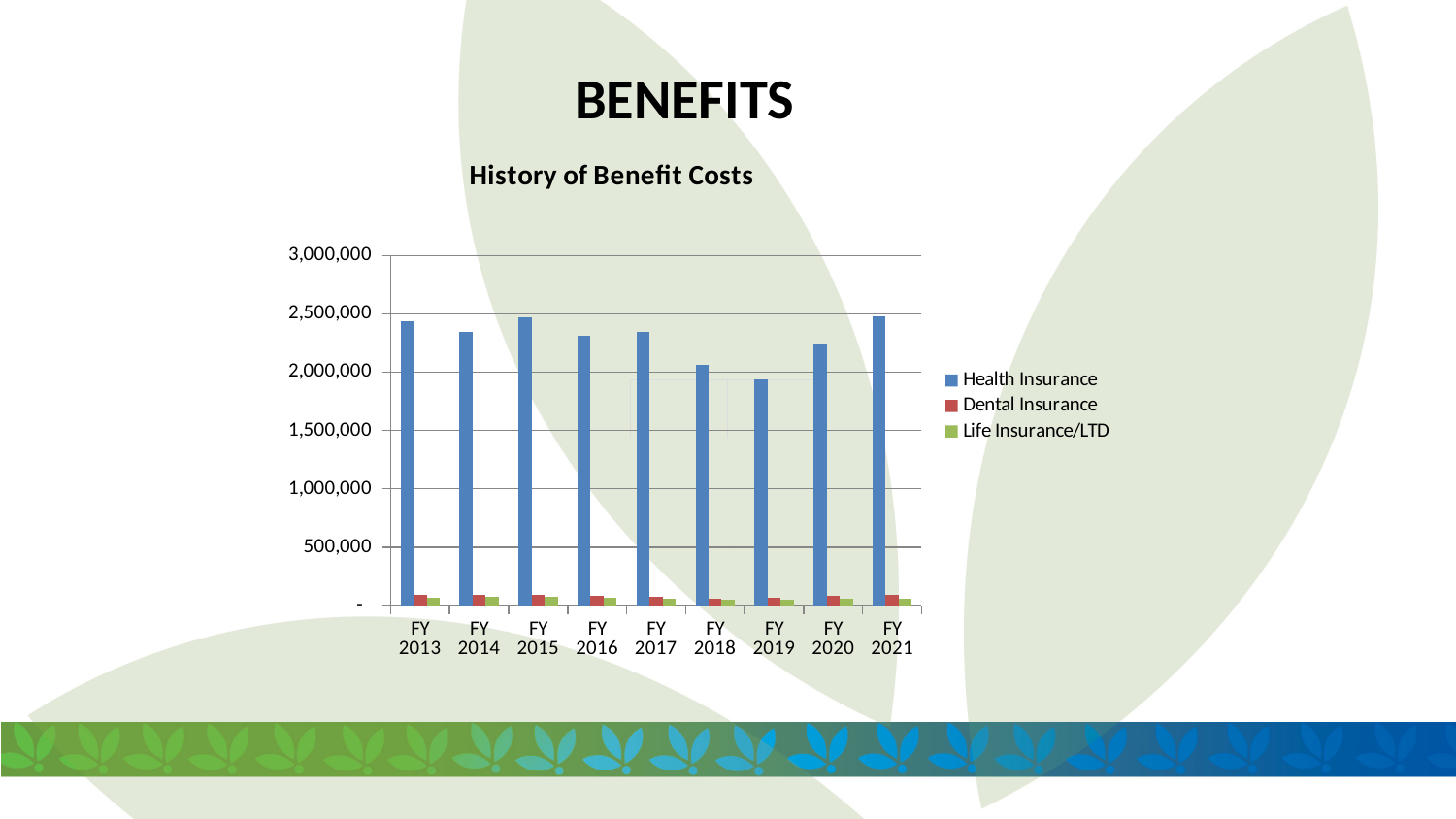
In which fiscal year is the Health Insurance cost lowest? FY 2019 What is the title of the chart? History of Benefit Costs Is the Dental Insurance value for FY 2015 greater or less than 500,000? less Which is larger, the Health Insurance cost in FY 2013 or in FY 2019? FY 2013 Which is larger, the Health Insurance cost in FY 2018 or in FY 2020? FY 2020 How many fiscal years are shown on the x axis? 9 Does the Health Insurance cost rise or fall from FY 2017 to FY 2019? fall Which series is shown in blue? Health Insurance What kind of chart is shown on the slide? bar chart How many series does the legend list? 3 Is the Health Insurance value for FY 2013 greater or less than 2,000,000? greater Is the Health Insurance value for FY 2019 greater or less than 2,000,000? less